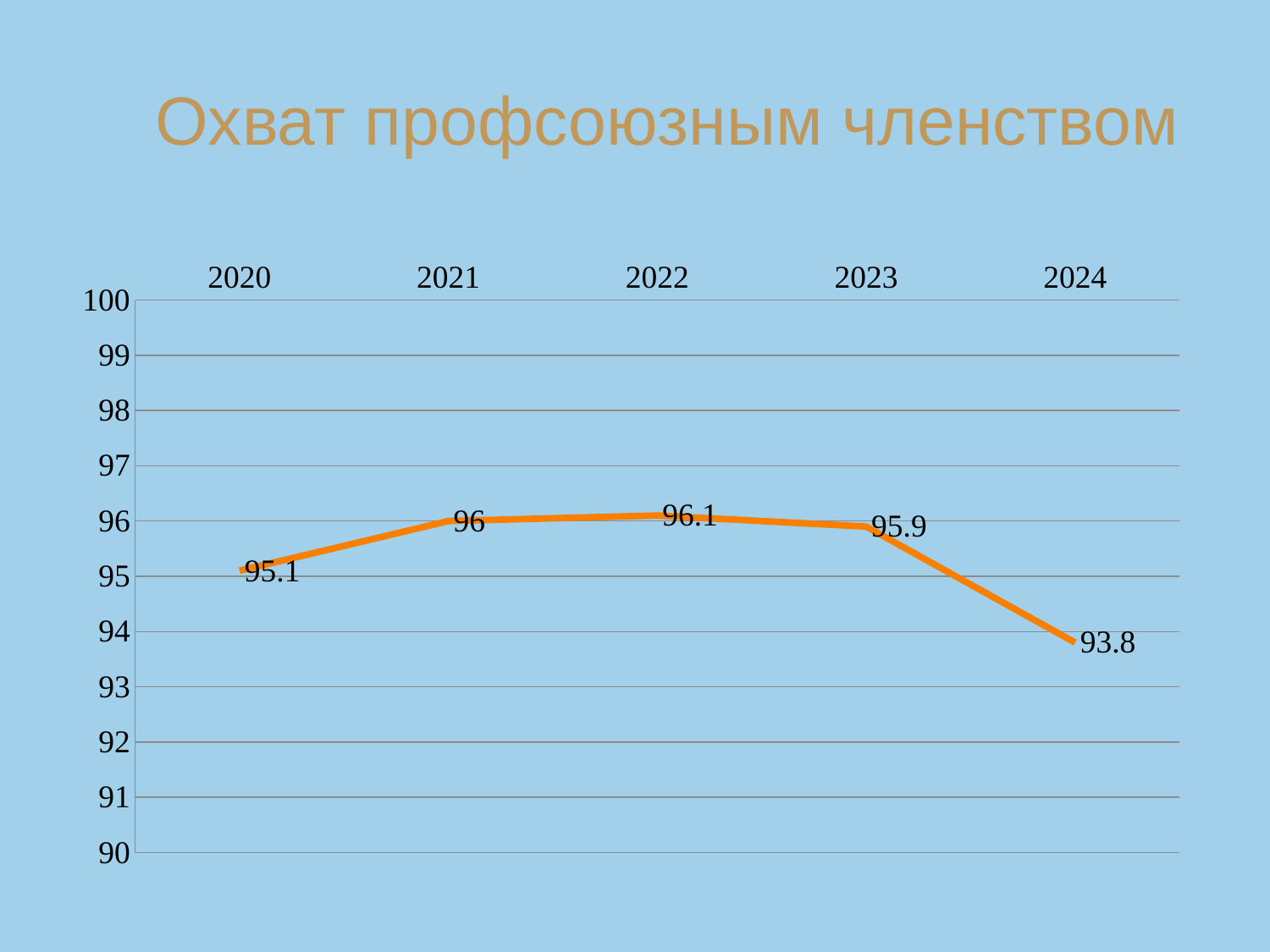
What is the difference between the values for 2023 and 2024? 2.1 Which year has the highest value? 2022 What is the title of the chart? Охват профсоюзным членством What is the value for 2024? 93.8 Which is larger, the value for 2020 or the value for 2024? 2020 What is the value for 2020? 95.1 How many years are plotted on the chart? 5 What is the difference between the values for 2021 and 2020? 0.9 What is the value for 2023? 95.9 What is the value for 2022? 96.1 What kind of chart is shown on the slide? line chart Which year has the lowest value? 2024